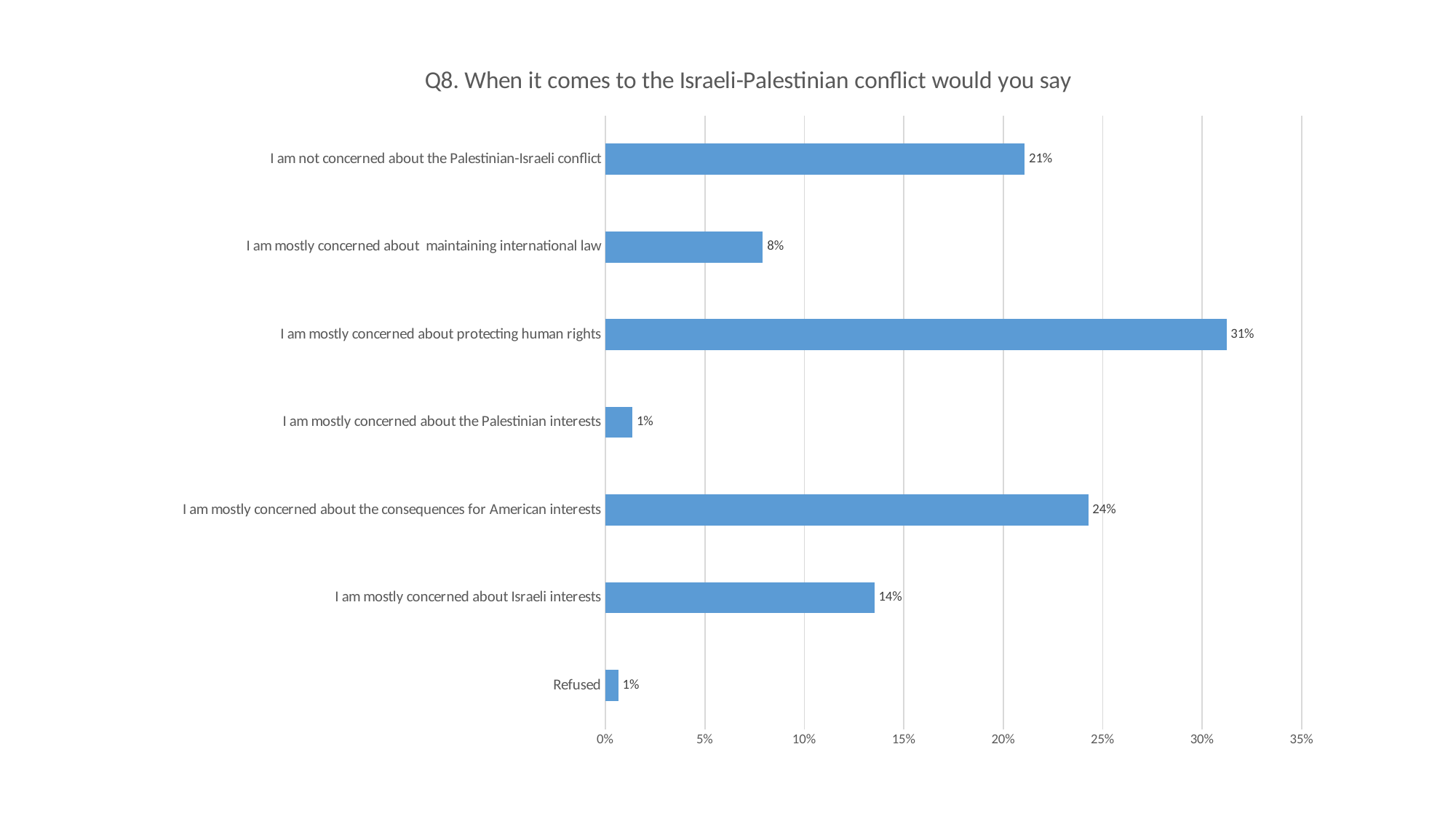
What percentage said they are mostly concerned about maintaining international law? 8% What is the value for "I am not concerned about the Palestinian-Israeli conflict"? 21% What kind of chart is shown on the slide? Bar chart Is the value for "I am mostly concerned about protecting human rights" greater or less than 30%? greater What is the difference between the percentage concerned about the consequences for American interests and the percentage concerned about Israeli interests? 10% How many response categories are shown in the chart? 7 What percentage of respondents said they are mostly concerned about protecting human rights? 31% Which is larger: the value for "I am not concerned about the Palestinian-Israeli conflict" or the value for "I am mostly concerned about the consequences for American interests"? I am mostly concerned about the consequences for American interests What is the highest value shown on the x axis? 35% What is the value for "I am mostly concerned about Israeli interests"? 14% Which response has the highest percentage? I am mostly concerned about protecting human rights What is the title of the chart? Q8. When it comes to the Israeli-Palestinian conflict would you say